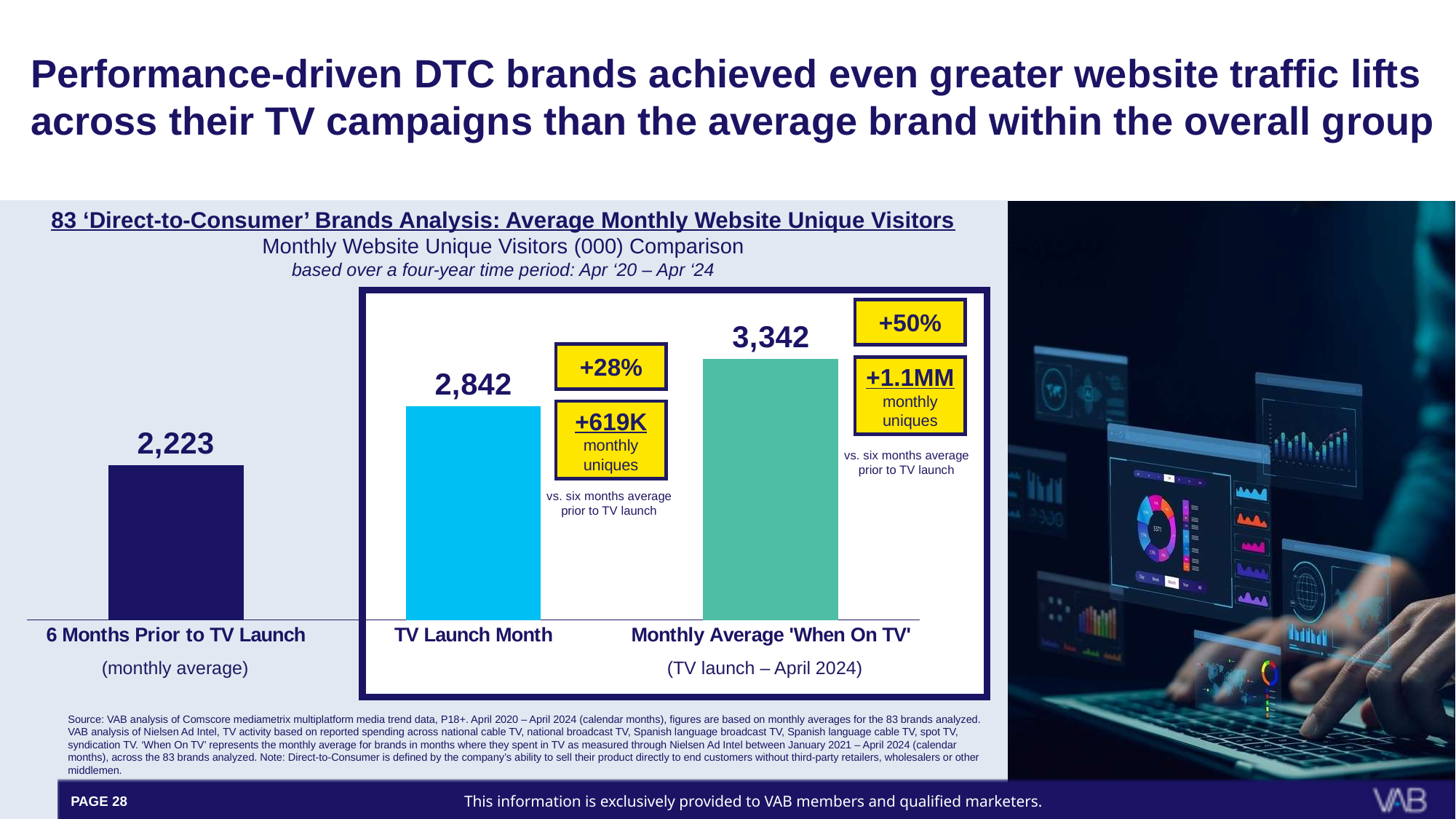
What kind of chart is shown on the slide? Bar chart What is the difference between the 'TV Launch Month' value and the '6 Months Prior to TV Launch' value? 619 Which category has the highest value in the chart? Monthly Average 'When On TV' How many bars are plotted in the chart? 3 Which category has the lowest value in the chart? 6 Months Prior to TV Launch What is the value shown for 'Monthly Average "When On TV"'? 3,342 Which is larger, the value for 'TV Launch Month' or the value for 'Monthly Average "When On TV"'? Monthly Average 'When On TV' What percentage lift is shown in the callout next to the 'Monthly Average "When On TV"' bar? +50% Do the values rise or fall from left to right across the chart? Rise What is the value shown for 'TV Launch Month'? 2,842 What is the average monthly website unique visitors (000) value for '6 Months Prior to TV Launch'? 2,223 What is the difference between the 'Monthly Average "When On TV"' value and the '6 Months Prior to TV Launch' value? 1,119